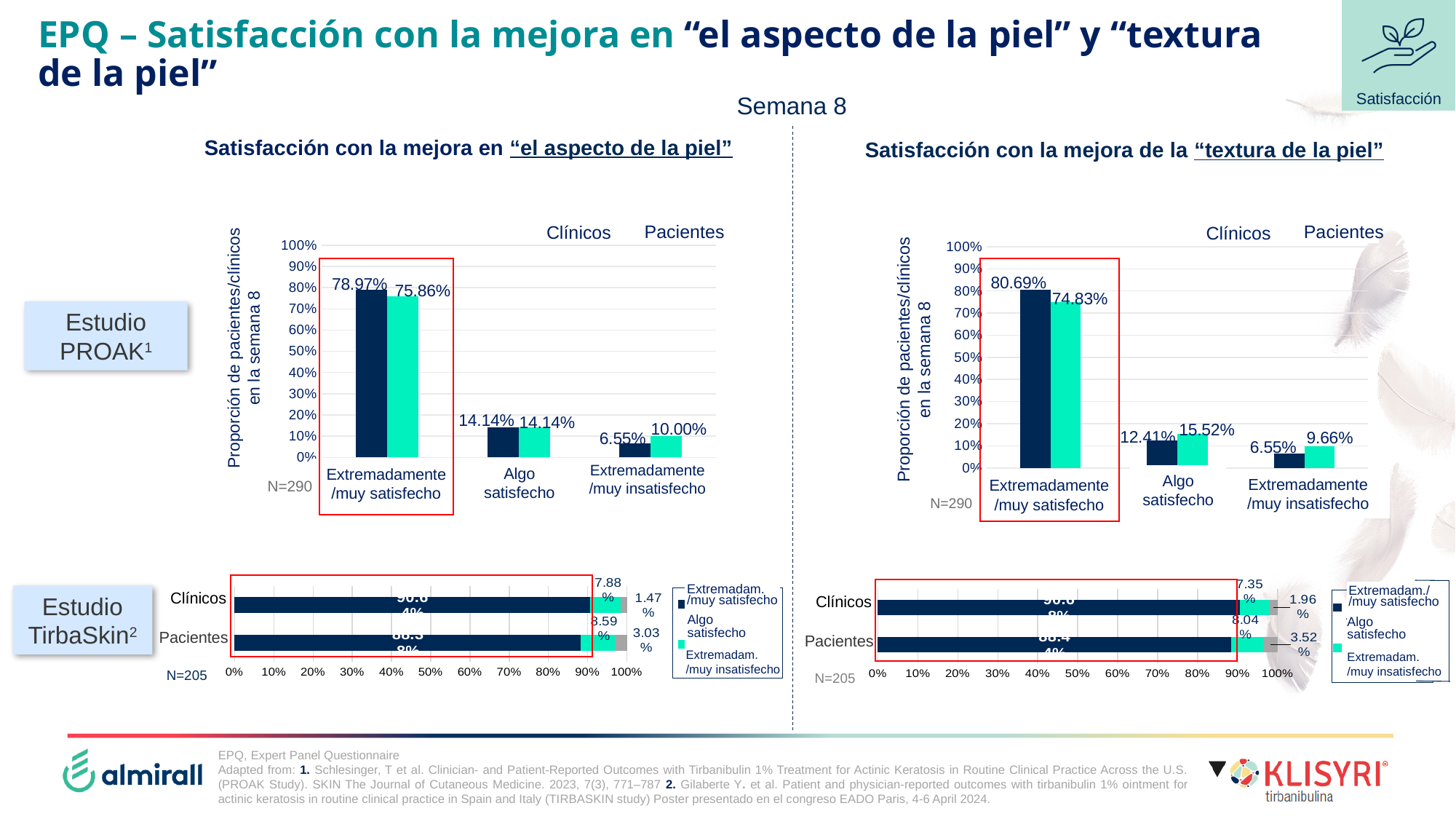
What is the N shown for the Estudio PROAK charts? N=290 In the top-right chart (Estudio PROAK, 'textura de la piel'), what is the difference between Clínicos and Pacientes in the 'Extremadamente/muy satisfecho' category? 5.86% In the top-right chart (Estudio PROAK, 'textura de la piel'), which category has the lowest value for Clínicos? Extremadamente/muy insatisfecho How many series does the legend of the top-left chart (Estudio PROAK, 'el aspecto de la piel') list? 2 In the top-right chart (Estudio PROAK, 'textura de la piel'), what is the value for Pacientes in the 'Extremadamente/muy satisfecho' category? 74.83% In the top-left chart (Estudio PROAK, 'el aspecto de la piel'), what is the value for Clínicos in the 'Extremadamente/muy satisfecho' category? 78.97% How many categories are shown on the x axis of the top-right chart (Estudio PROAK, 'textura de la piel')? 3 What kind of chart is the bottom-left chart (Estudio TirbaSkin, 'el aspecto de la piel')? Stacked horizontal bar chart In the bottom-left chart (Estudio TirbaSkin, 'el aspecto de la piel'), what is the 'Extremadamente/muy insatisfecho' value for Pacientes? 3.03% In the top-left chart (Estudio PROAK, 'el aspecto de la piel'), which is larger in the 'Extremadamente/muy satisfecho' category, Clínicos or Pacientes? Clínicos In the bottom-right chart (Estudio TirbaSkin, 'textura de la piel'), what is the 'Algo satisfecho' value for Clínicos? 7.35% In the top-left chart (Estudio PROAK, 'el aspecto de la piel'), what is the value for Pacientes in the 'Extremadamente/muy insatisfecho' category? 10.00%